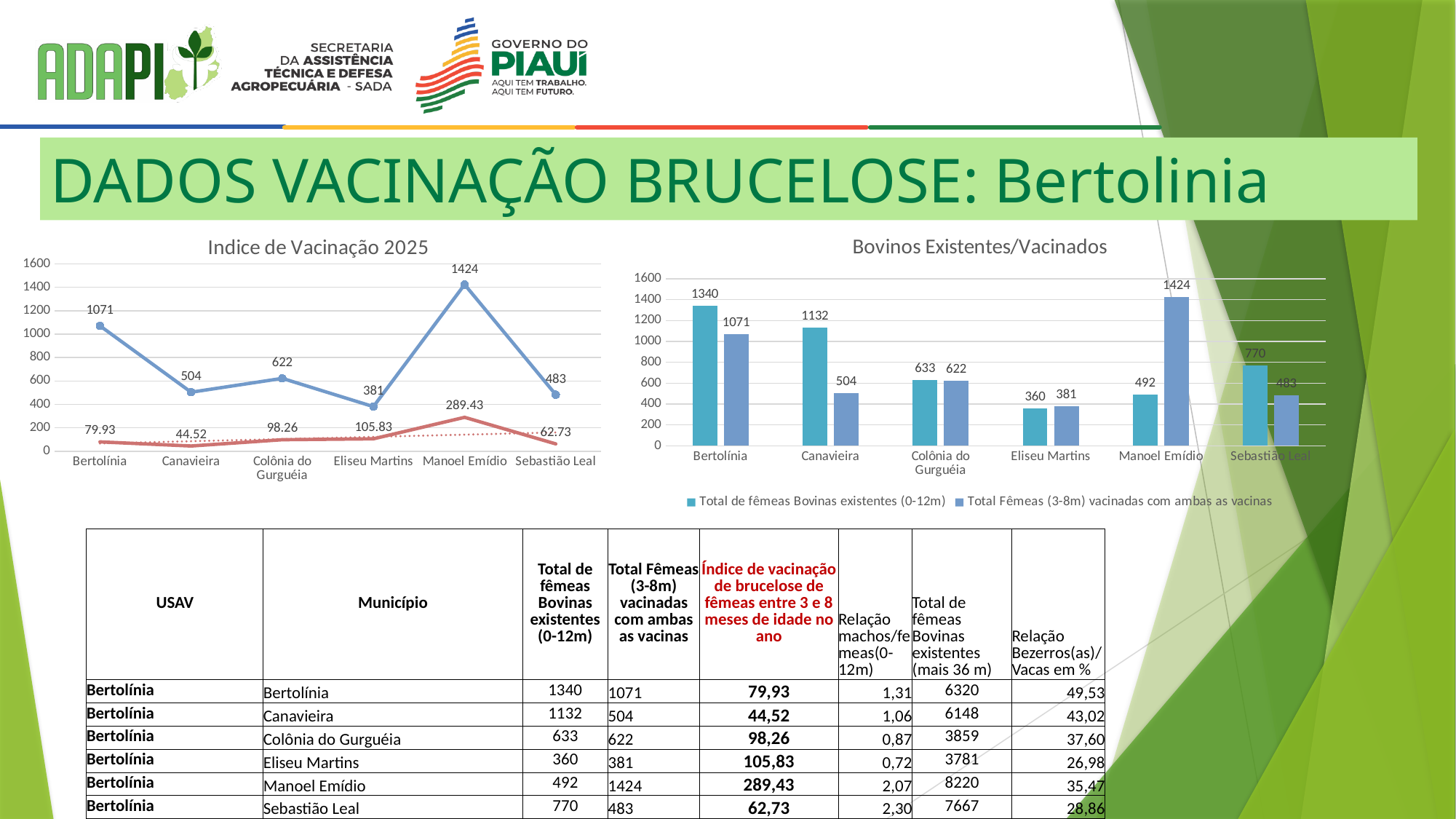
In the 'Bovinos Existentes/Vacinados' chart, which municipality has the lowest value for 'Total Fêmeas (3-8m) vacinadas com ambas as vacinas'? Eliseu Martins In the 'Bovinos Existentes/Vacinados' chart, which municipality has the highest value for 'Total de fêmeas Bovinas existentes (0-12m)'? Bertolínia What kind of chart is 'Bovinos Existentes/Vacinados'? Bar chart In the 'Indice de Vacinação 2025' chart, which municipality has the lowest value on the lower (red) line? Canavieira In the 'Bovinos Existentes/Vacinados' chart, how many series does the legend list? 2 In the 'Bovinos Existentes/Vacinados' chart, what is the value of 'Total de fêmeas Bovinas existentes (0-12m)' for Bertolínia? 1340 In the 'Indice de Vacinação 2025' chart, how many municipalities are shown on the x axis? 6 In the 'Indice de Vacinação 2025' chart, what is the value of the lower (red) line for Manoel Emídio? 289.43 What kind of chart is 'Indice de Vacinação 2025'? Line chart In the 'Bovinos Existentes/Vacinados' chart, what is the value of 'Total Fêmeas (3-8m) vacinadas com ambas as vacinas' for Manoel Emídio? 1424 In the 'Bovinos Existentes/Vacinados' chart, what is the difference between the two bars for Canavieira? 628 In the 'Indice de Vacinação 2025' chart, is the upper (blue) line value for Eliseu Martins larger or smaller than the value for Colônia do Gurguéia? Smaller